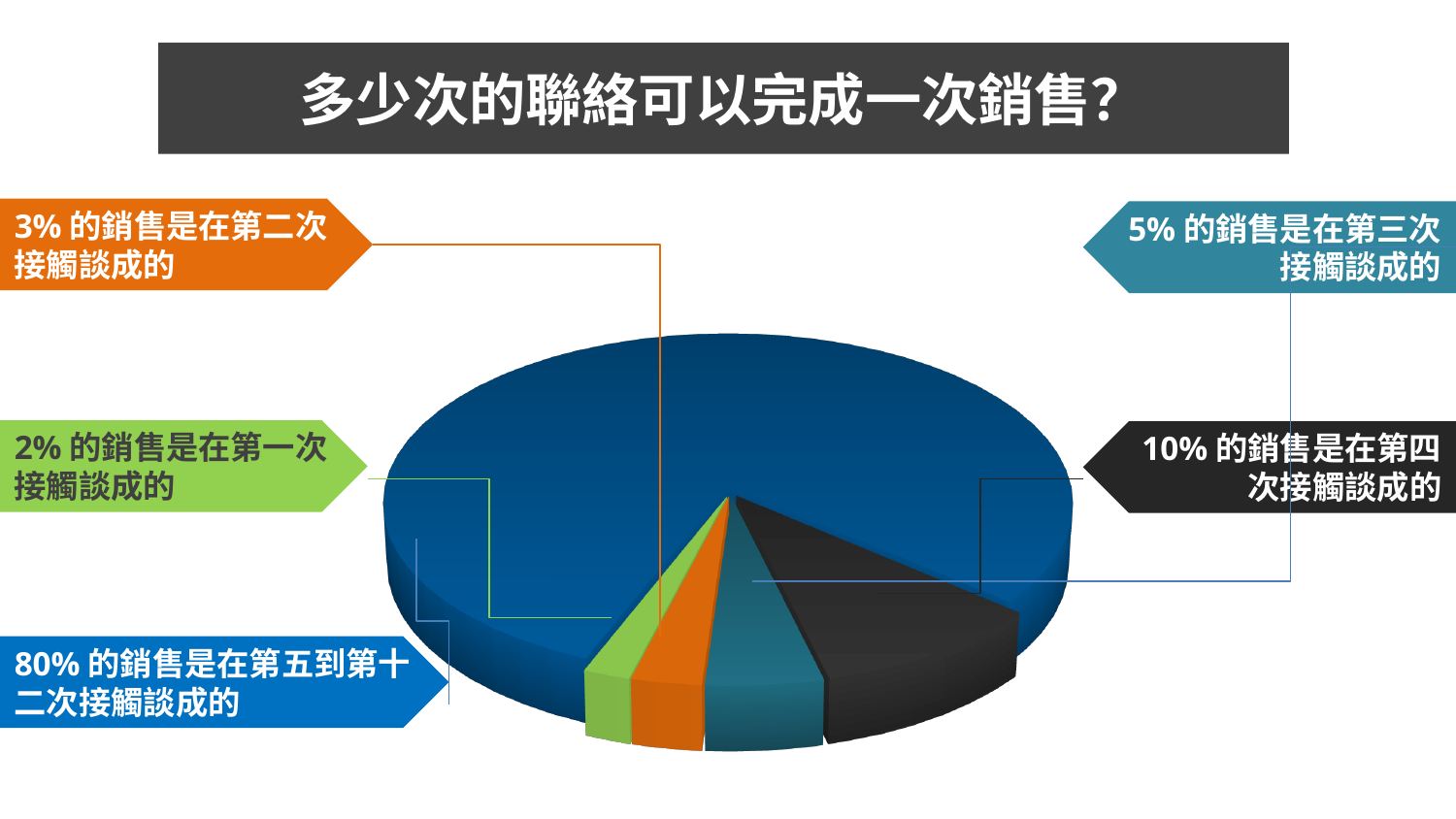
Which slice of the pie chart is the smallest? 第一次接觸 (2%) What percentage of sales are closed between the fifth and twelfth contact (第五到第十二次接觸)? 80% How many slices does the pie chart have? 5 Which is larger: the share of sales closed on the second contact or on the third contact? 第三次接觸 (5%) What kind of chart is shown on the slide? pie chart What percentage of sales are closed on the first contact (第一次接觸)? 2% What percentage of sales are closed on the second contact (第二次接觸)? 3% What percentage of sales are closed on the fourth contact (第四次接觸)? 10% What is the title of the slide above the chart? 多少次的聯絡可以完成一次銷售? What is the difference between the share of sales closed on the fourth contact and the share closed on the third contact? 5% What percentage of sales are closed on the third contact (第三次接觸)? 5% Which slice of the pie chart is the largest? 第五到第十二次接觸 (80%)